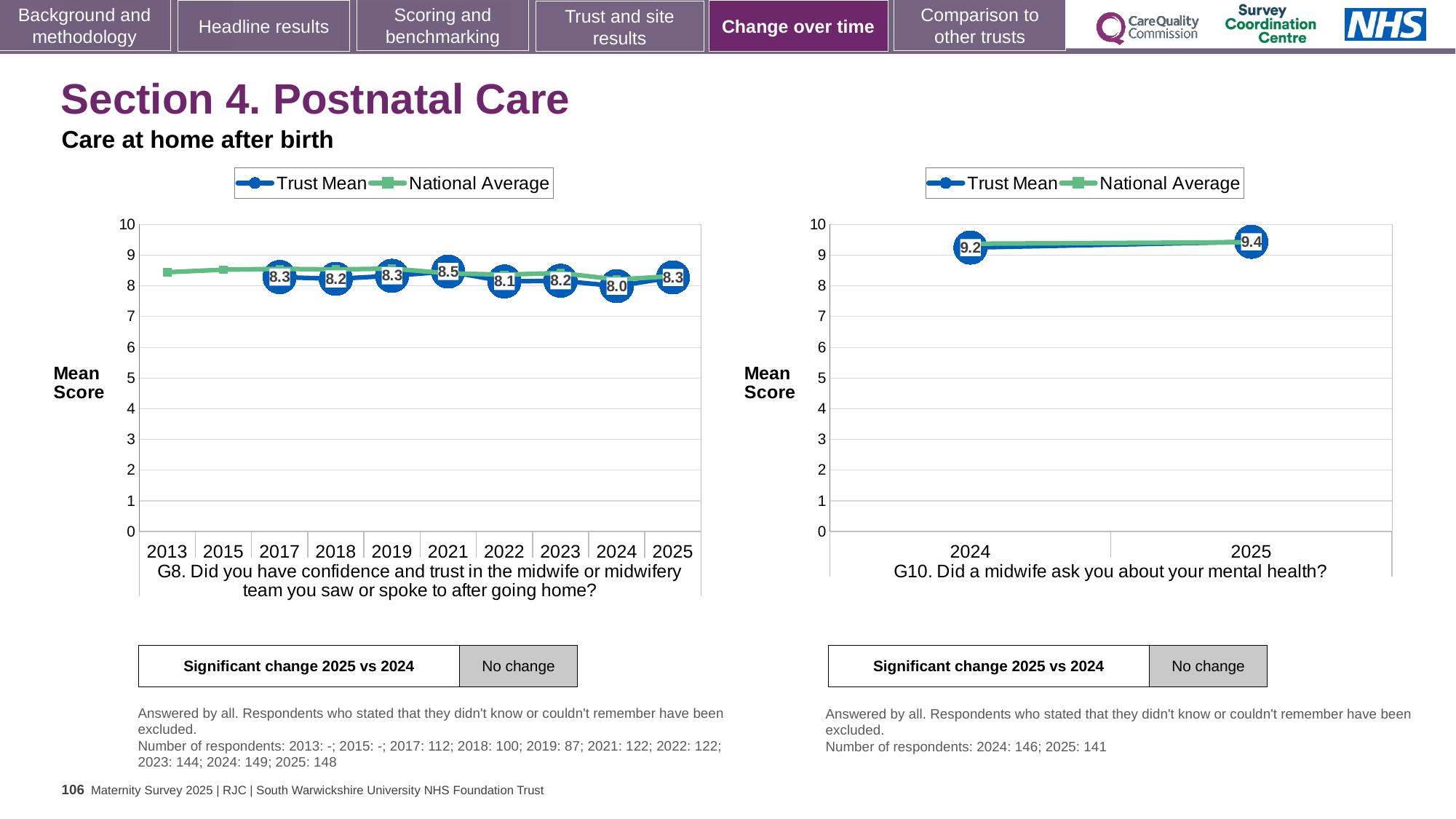
How many series does the legend of the G10 chart on the right list? 2 In the G8 chart on the left, which year has the lowest Trust Mean? 2024 In the G8 chart on the left, how many years are shown on the x axis? 10 In the G10 chart on the right, what is the difference between the Trust Mean in 2025 and in 2024? 0.2 In the G10 chart on the right, does the Trust Mean rise or fall from 2024 to 2025? rise In the G8 chart on the left, which year has the highest Trust Mean? 2021 In the G10 chart on the right, what is the Trust Mean for 2025? 9.4 In the G8 chart on the left, is the Trust Mean higher in 2025 or in 2024? 2025 In the G8 chart on the left, what is the Trust Mean for 2021? 8.5 What type of chart is the G8 chart on the left? line chart In the G8 chart on the left, what is the difference between the Trust Mean in 2021 and in 2024? 0.5 In the G8 chart on the left, what is the Trust Mean for 2024? 8.0